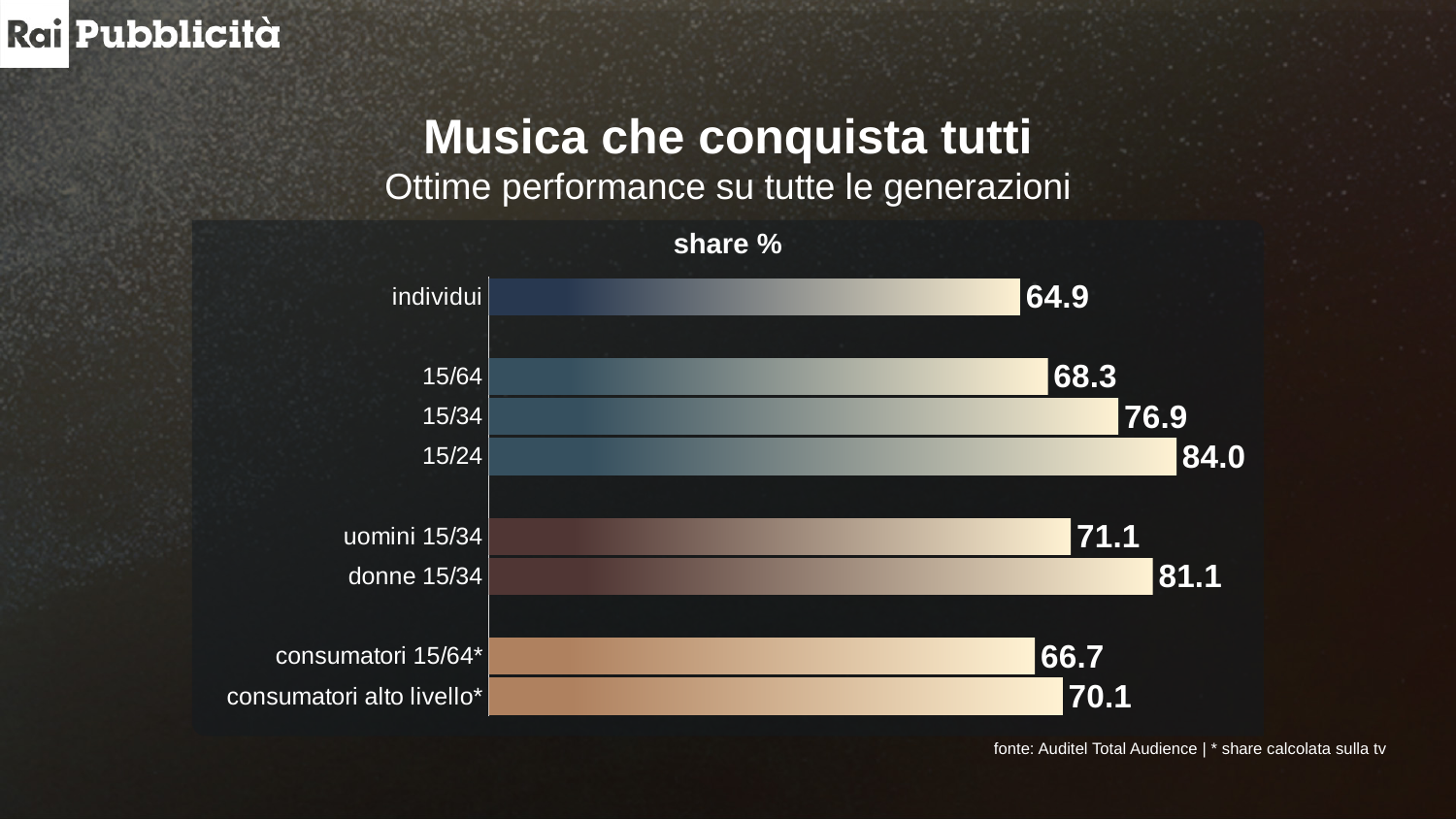
What is the share % for donne 15/34? 81.1 Which has a higher share %, 15/34 or consumatori 15/64*? 15/34 What is the share % for individui? 64.9 What is the share % for 15/24? 84.0 What is the difference in share % between 15/24 and 15/64? 15.7 Which category has the highest share %? 15/24 What is the difference in share % between donne 15/34 and uomini 15/34? 10.0 Which category has the lowest share %? individui What kind of chart is shown on the slide? bar chart What is the title shown above the chart bars? share % What is the share % for consumatori alto livello*? 70.1 How many categories are shown in the chart? 8